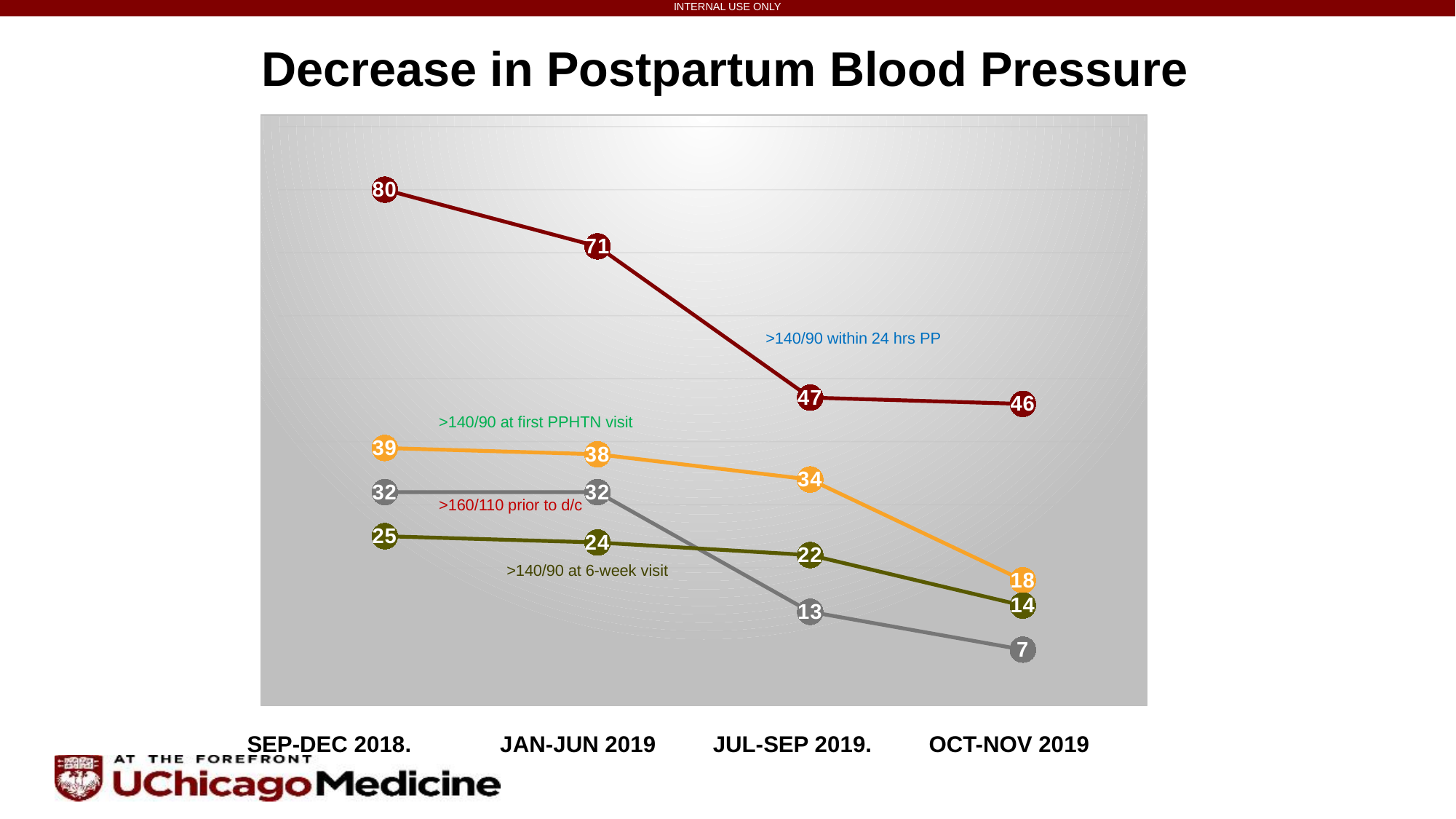
Which is larger for OCT-NOV 2019: the ">140/90 at first PPHTN visit" value or the ">140/90 at 6-week visit" value? >140/90 at first PPHTN visit In which period is the ">140/90 within 24 hrs PP" series highest? SEP-DEC 2018. What is the difference between the ">140/90 within 24 hrs PP" values for SEP-DEC 2018 and OCT-NOV 2019? 34 What is the value of the ">140/90 at 6-week visit" series for JAN-JUN 2019? 24 How many time periods are shown on the x axis? 4 In which period is the ">160/110 prior to d/c" series lowest? OCT-NOV 2019 Does the ">140/90 within 24 hrs PP" series rise or fall from SEP-DEC 2018 to OCT-NOV 2019? fall What is the value of the ">140/90 at first PPHTN visit" series for JUL-SEP 2019? 34 What is the value of the ">160/110 prior to d/c" series for OCT-NOV 2019? 7 What type of chart is shown on the slide? line chart What is the value of the ">140/90 within 24 hrs PP" series for SEP-DEC 2018? 80 What is the value of the ">140/90 within 24 hrs PP" series for OCT-NOV 2019? 46